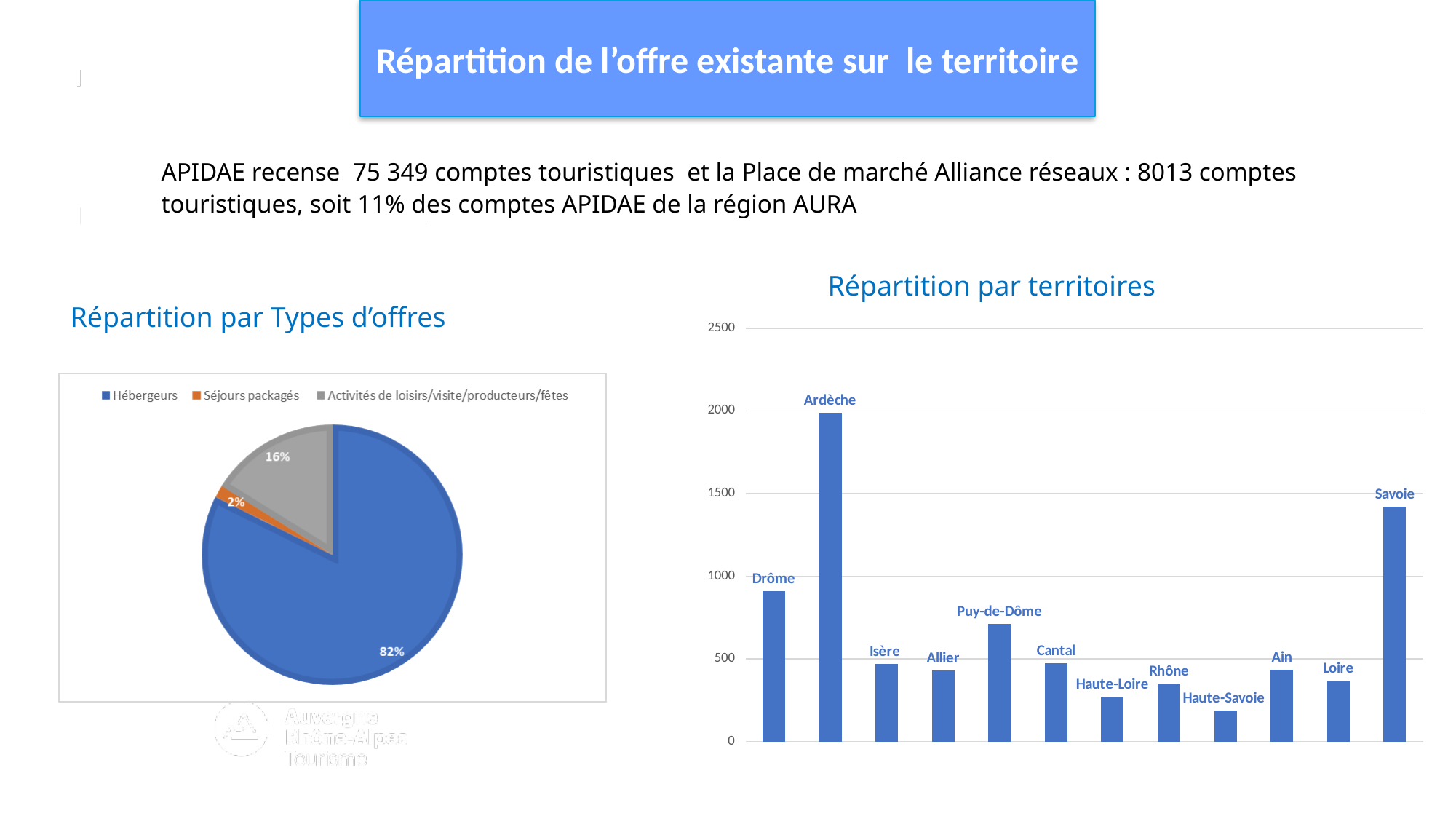
In the 'Répartition par territoires' chart, which territory has the highest bar? Ardèche What kind of chart is 'Répartition par Types d'offres'? Pie chart In the 'Répartition par territoires' chart, which is larger, Drôme or Puy-de-Dôme? Drôme In the 'Répartition par territoires' chart, is the value for Savoie greater or less than 1000? greater In the 'Répartition par Types d'offres' chart, what share of the pie is Hébergeurs? 82% In the 'Répartition par Types d'offres' chart, what is the difference in percentage points between Hébergeurs and Activités de loisirs/visite/producteurs/fêtes? 66 percentage points In the 'Répartition par Types d'offres' chart, what share of the pie is Activités de loisirs/visite/producteurs/fêtes? 16% In the 'Répartition par Types d'offres' chart, which category has the smallest slice? Séjours packagés How many territories are shown in the 'Répartition par territoires' chart? 12 In the 'Répartition par territoires' chart, which territory has the lowest bar? Haute-Savoie In the 'Répartition par Types d'offres' chart, how many categories does the legend list? 3 In the 'Répartition par territoires' chart, is the value for Haute-Loire greater or less than 500? less